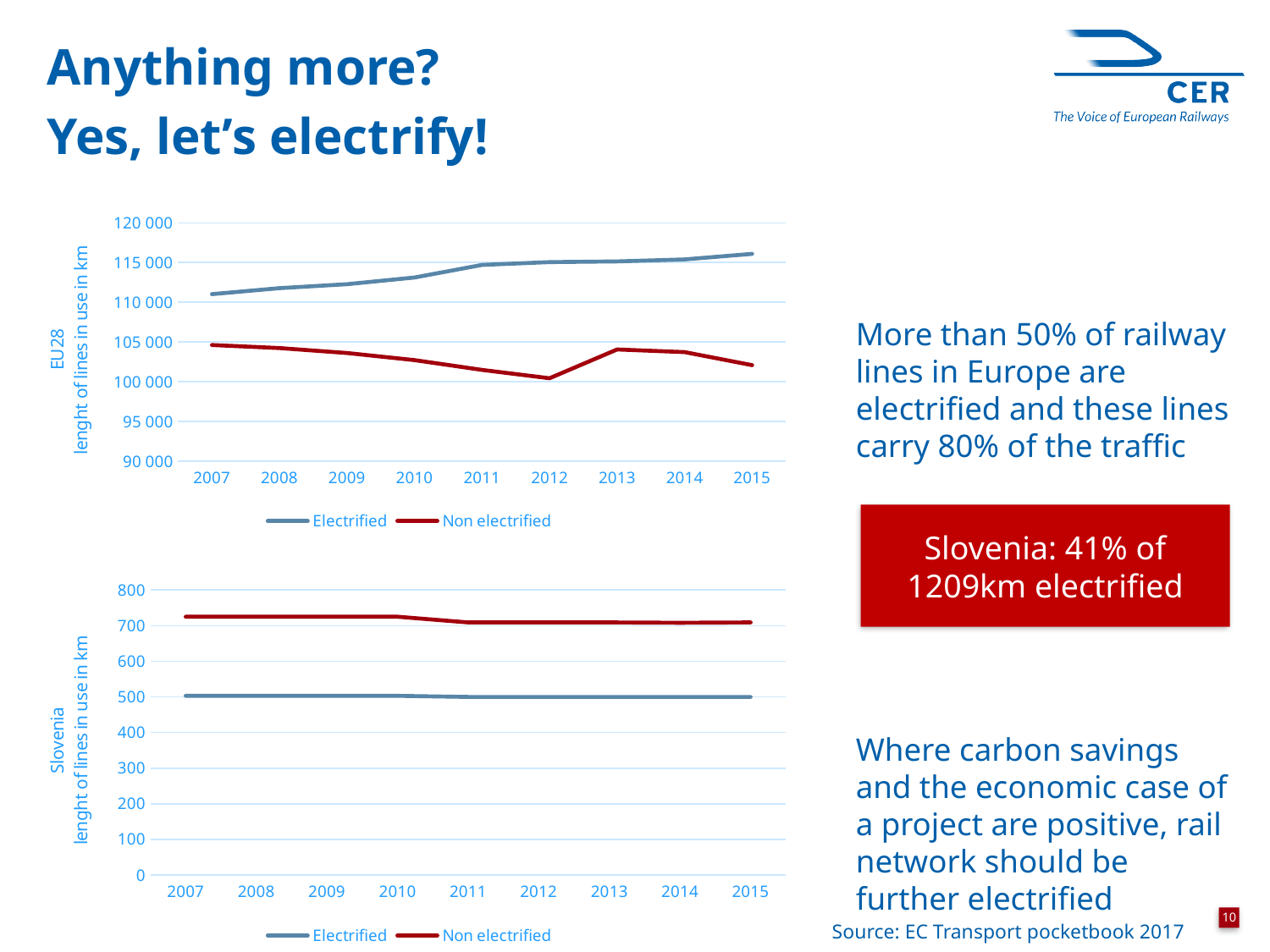
In the Slovenia chart, which series has the larger value in 2010, Electrified or Non electrified? Non electrified In the EU28 chart, is the Electrified value for 2015 greater or less than 115 000? greater What kind of chart is the EU28 chart at the top of the slide? line chart In the Slovenia chart, is the Non electrified value for 2007 greater or less than 700? greater In the EU28 chart, does the Electrified line rise or fall from 2007 to 2015? rise In the EU28 chart, is the Electrified value for 2007 greater or less than 110 000? greater In the EU28 chart, which series has the larger value in 2015, Electrified or Non electrified? Electrified How many years are plotted along the x axis of the Slovenia chart? 9 How many series does the legend of the EU28 chart list? 2 What are the two series named in the legend of the Slovenia chart? Electrified and Non electrified What is the y-axis label of the Slovenia chart? lenght of lines in use in km